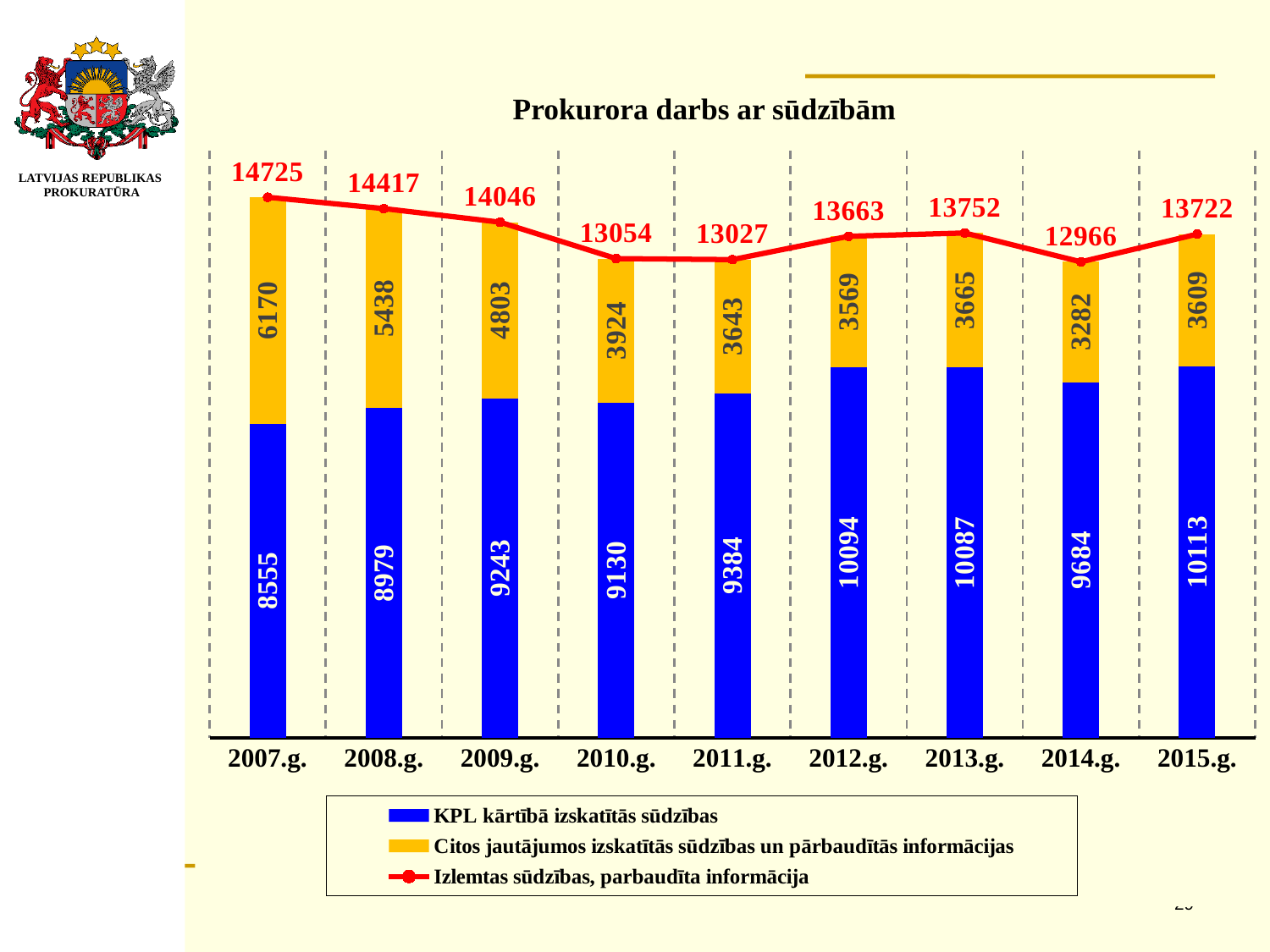
How many series does the legend list? 3 In which year is 'Citos jautājumos izskatītās sūdzības un pārbaudītās informācijas' lowest? 2014.g. What kind of chart is this? Stacked bar chart with a line Does 'Citos jautājumos izskatītās sūdzības un pārbaudītās informācijas' generally rise or fall from 2007.g. to 2011.g.? Fall What is the value of 'Izlemtas sūdzības, parbaudīta informācija' for 2011.g.? 13027 Which is larger: 'KPL kārtībā izskatītās sūdzības' in 2012.g. or in 2013.g.? 2012.g. What is the value of 'Citos jautājumos izskatītās sūdzības un pārbaudītās informācijas' for 2014.g.? 3282 What is the difference between the 'KPL kārtībā izskatītās sūdzības' values for 2015.g. and 2007.g.? 1558 What is the title of the chart? Prokurora darbs ar sūdzībām What is the value of 'KPL kārtībā izskatītās sūdzības' for 2007.g.? 8555 In which year is 'Izlemtas sūdzības, parbaudīta informācija' highest? 2007.g. How many years are shown on the x axis? 9